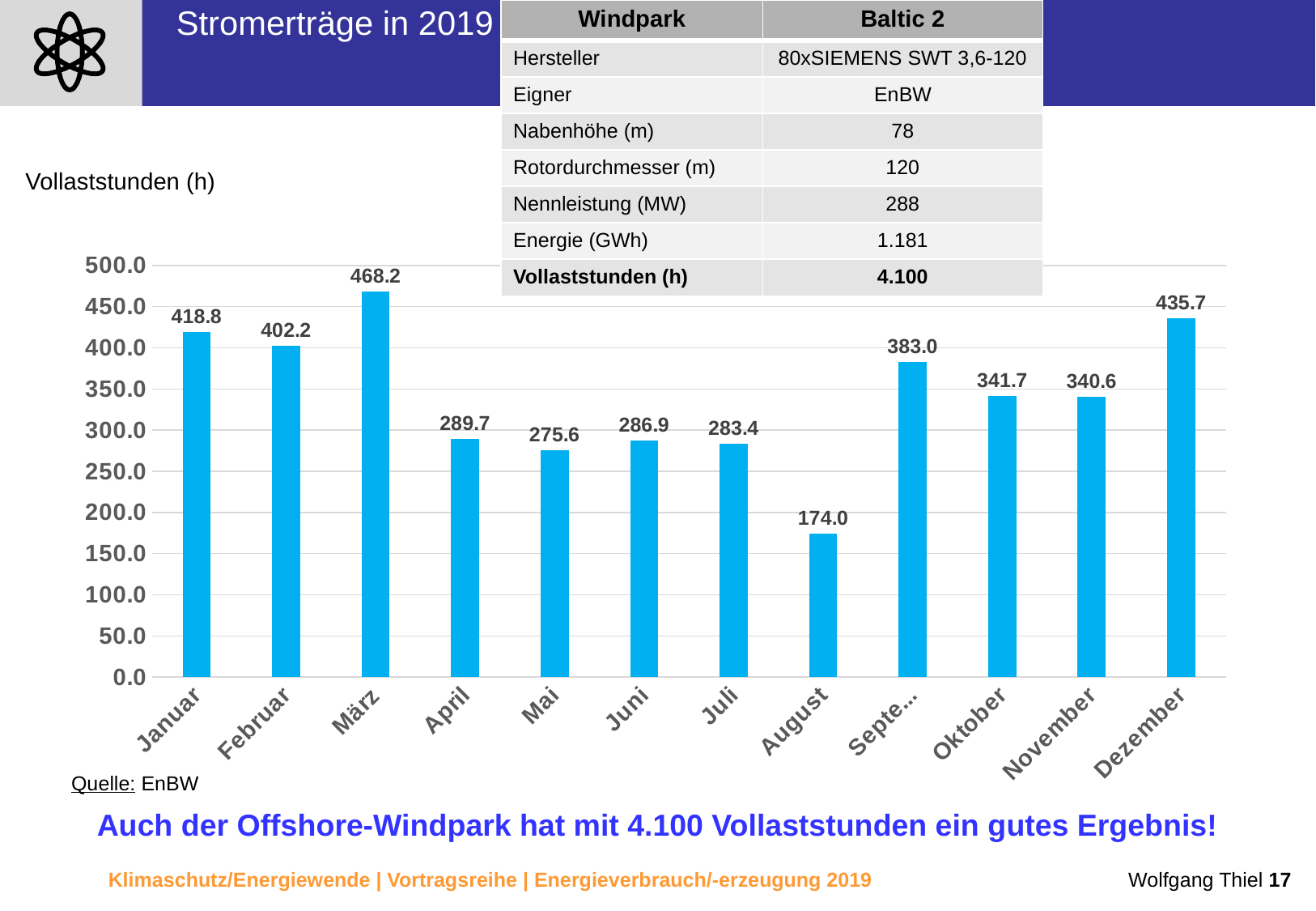
Which month has the highest value in the bar chart? März What is the difference between the values for Januar and Februar? 16.6 Which is larger, the value for Januar or the value for Dezember? Dezember What is the difference between the values for März and August? 294.2 How many months (bars) are shown in the bar chart? 12 What is the value for August in the bar chart? 174.0 Which month has the lowest value in the bar chart? August What kind of chart is shown on the slide? bar chart What is the label shown above the chart describing the plotted quantity? Vollaststunden (h) What is the value for März in the bar chart? 468.2 What is the value for Dezember in the bar chart? 435.7 Is the value for Mai greater or less than 300.0? less